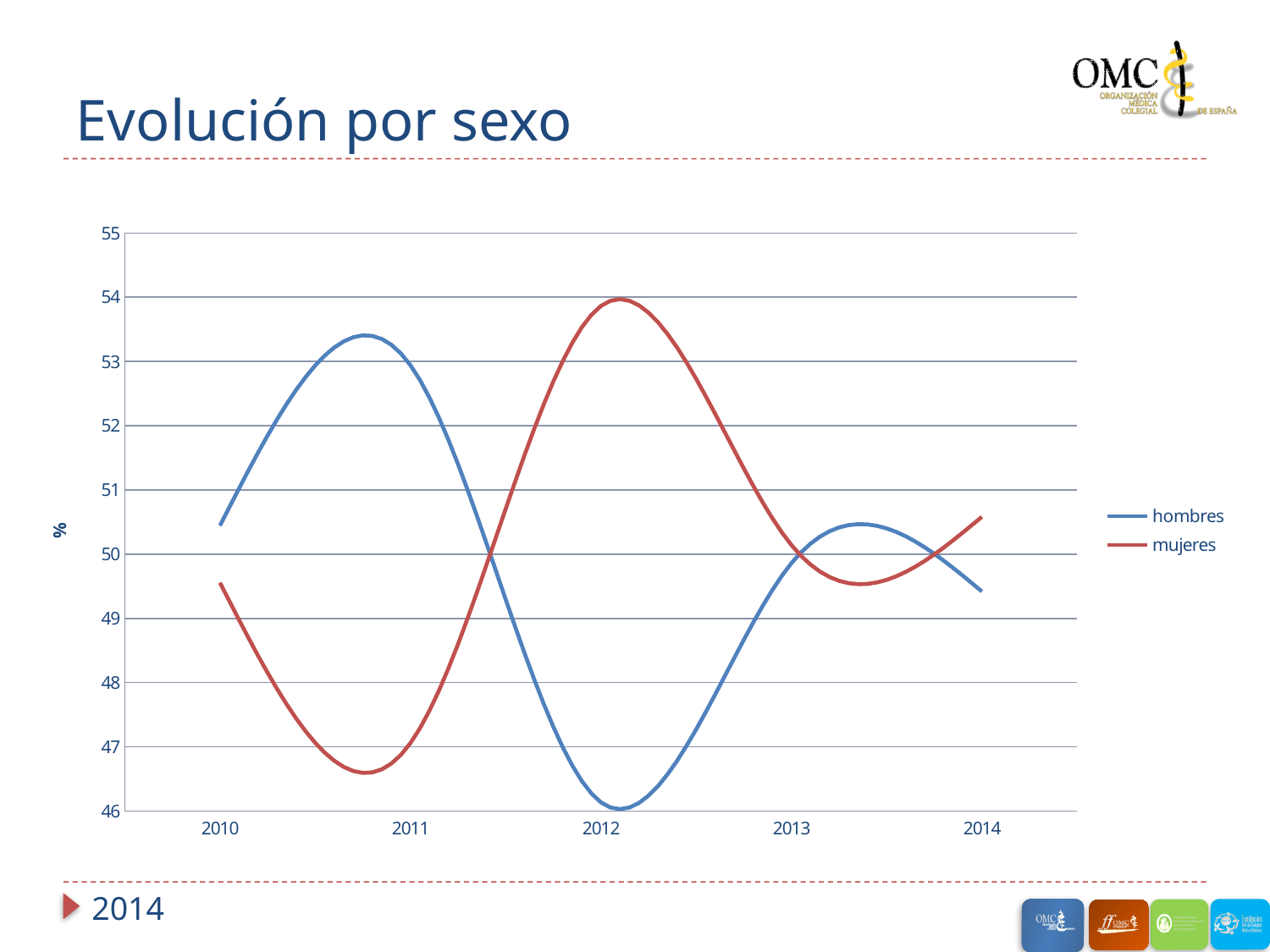
In which year does the mujeres series reach its lowest value? 2011 Is the value for mujeres in 2011 greater or less than 48? less In which year does the hombres series reach its lowest value? 2012 Does the hombres series rise or fall from 2011 to 2012? fall In which year does the mujeres series reach its highest value? 2012 Is the value for mujeres in 2012 greater or less than 53? greater Is the value for hombres in 2012 greater or less than 47? less What kind of chart is shown on the slide? line chart How many years are shown on the x axis? 5 In 2011, which series has the larger value, hombres or mujeres? hombres In which year does the hombres series reach its highest value? 2011 How many series does the legend list? 2